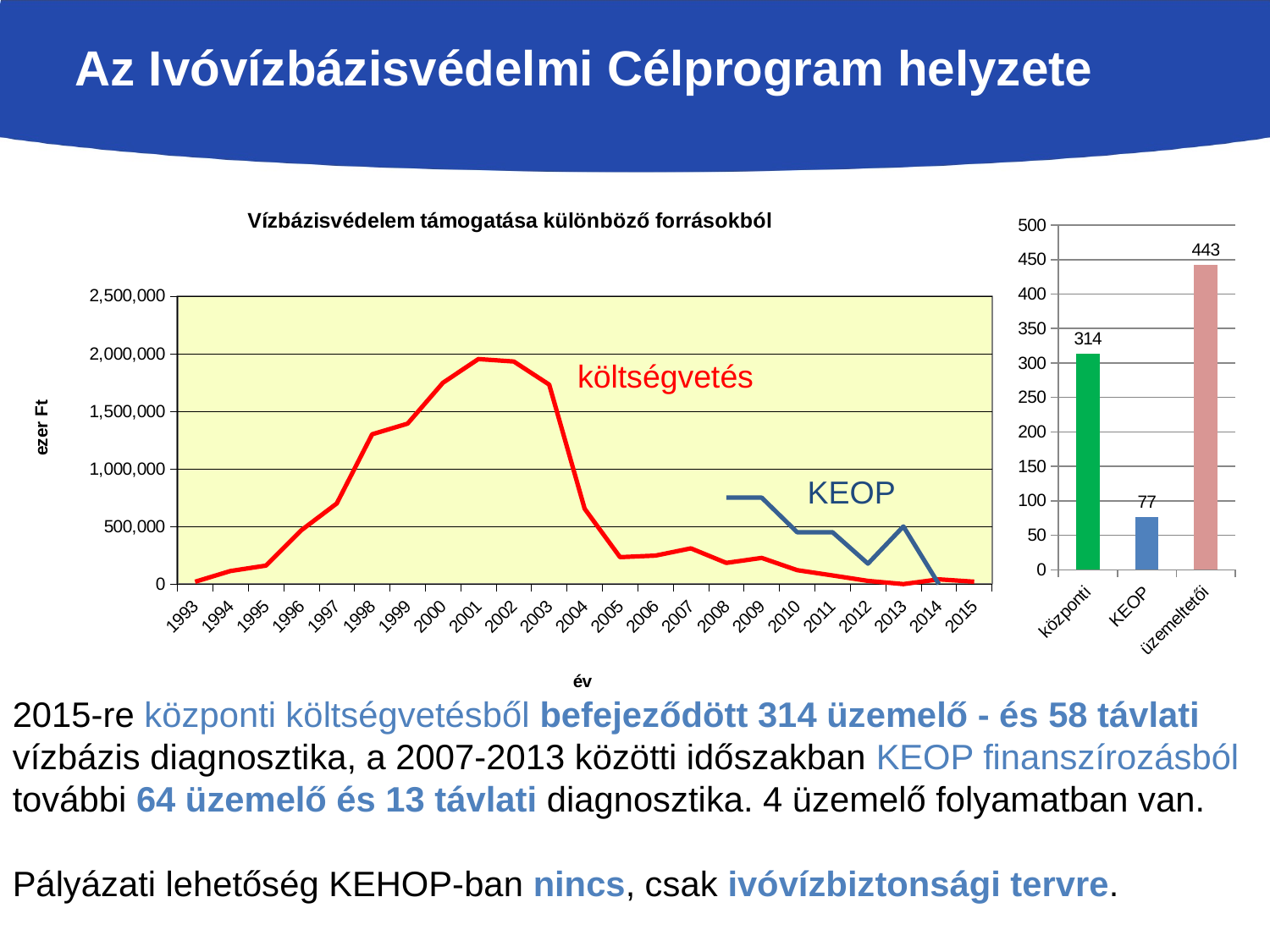
In the bar chart on the right, which category has the highest value? üzemeltetői In the bar chart on the right, which category has the lowest value? KEOP What kind of chart is the chart titled 'Vízbázisvédelem támogatása különböző forrásokból'? line chart In the bar chart on the right, how many categories are shown? 3 In the chart titled 'Vízbázisvédelem támogatása különböző forrásokból', is the költségvetés value for 2001 greater or less than 1,500,000? greater In the chart titled 'Vízbázisvédelem támogatása különböző forrásokból', is the költségvetés value for 2005 greater or less than 500,000? less In the bar chart on the right, what is the value for üzemeltetői? 443 In the chart titled 'Vízbázisvédelem támogatása különböző forrásokból', what is the label on the y axis? ezer Ft What kind of chart is the chart on the right of the slide? bar chart In the bar chart on the right, what is the difference between the values for üzemeltetői and központi? 129 In the bar chart on the right, what is the value for központi? 314 In the bar chart on the right, what is the value for KEOP? 77